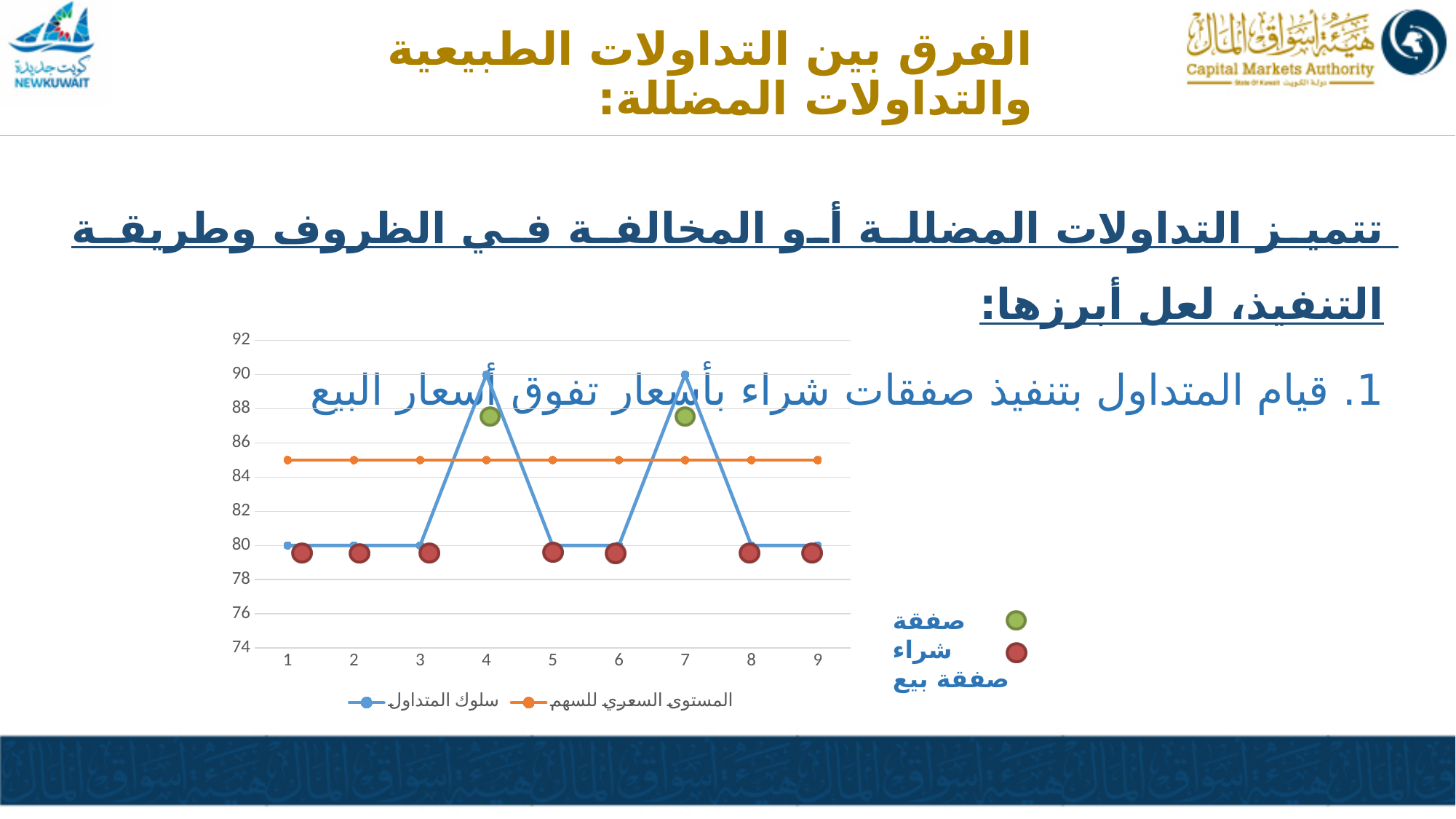
How many points are plotted along the x axis for each series? 9 How many series does the chart legend list? 2 What is the difference between the سلوك المتداول values at x = 4 and x = 1? 10 What is the value of the سلوك المتداول series at x = 7? 90 Does the المستوى السعري للسهم series rise, fall, or stay flat across the x axis? Stays flat At x = 2, which series has the larger value, سلوك المتداول or المستوى السعري للسهم? المستوى السعري للسهم At x = 4, which series has the larger value, سلوك المتداول or المستوى السعري للسهم? سلوك المتداول What is the value of the سلوك المتداول series at x = 1? 80 What is the value of the سلوك المتداول series at x = 4? 90 What kind of chart is shown on the slide? Line chart Is the value of the المستوى السعري للسهم series greater or less than 84? greater At which x values does the سلوك المتداول series reach its highest value? 4 and 7